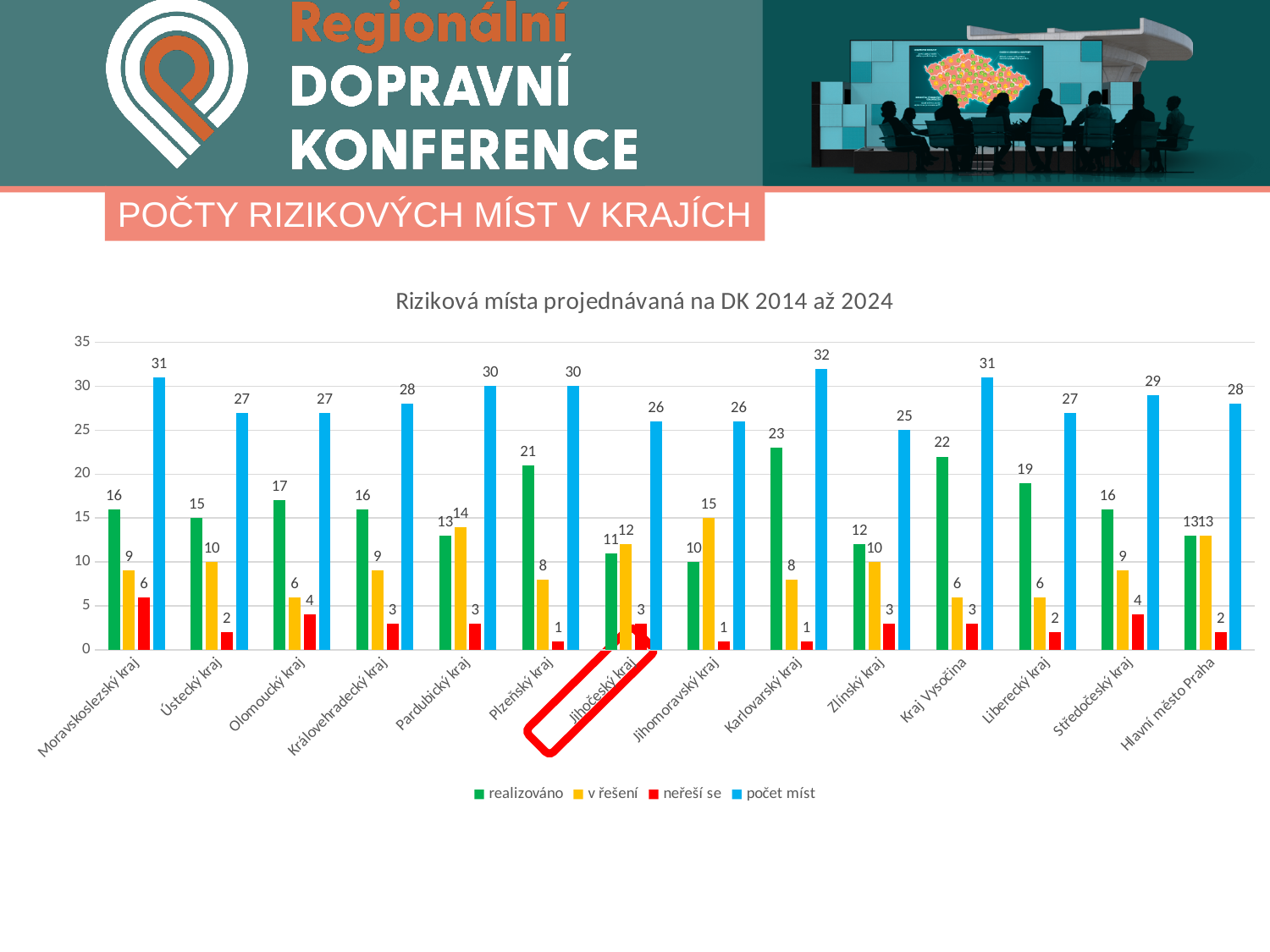
What is the value of 'realizováno' for Plzeňský kraj? 21 Which region has the lowest 'počet míst' value? Zlínský kraj What is the value of 'v řešení' for Jihomoravský kraj? 15 What is the title of the chart? Riziková místa projednávaná na DK 2014 až 2024 How many series does the legend list? 4 Which region has the highest 'počet míst' value? Karlovarský kraj What is the value of 'neřeší se' for Moravskoslezský kraj? 6 What type of chart is shown on the slide? bar chart What is the difference between 'počet míst' and 'realizováno' for Jihočeský kraj? 15 What is the value of 'počet míst' for Karlovarský kraj? 32 Which is larger for Pardubický kraj: 'realizováno' or 'v řešení'? v řešení How many regions (categories) are shown on the x axis? 14